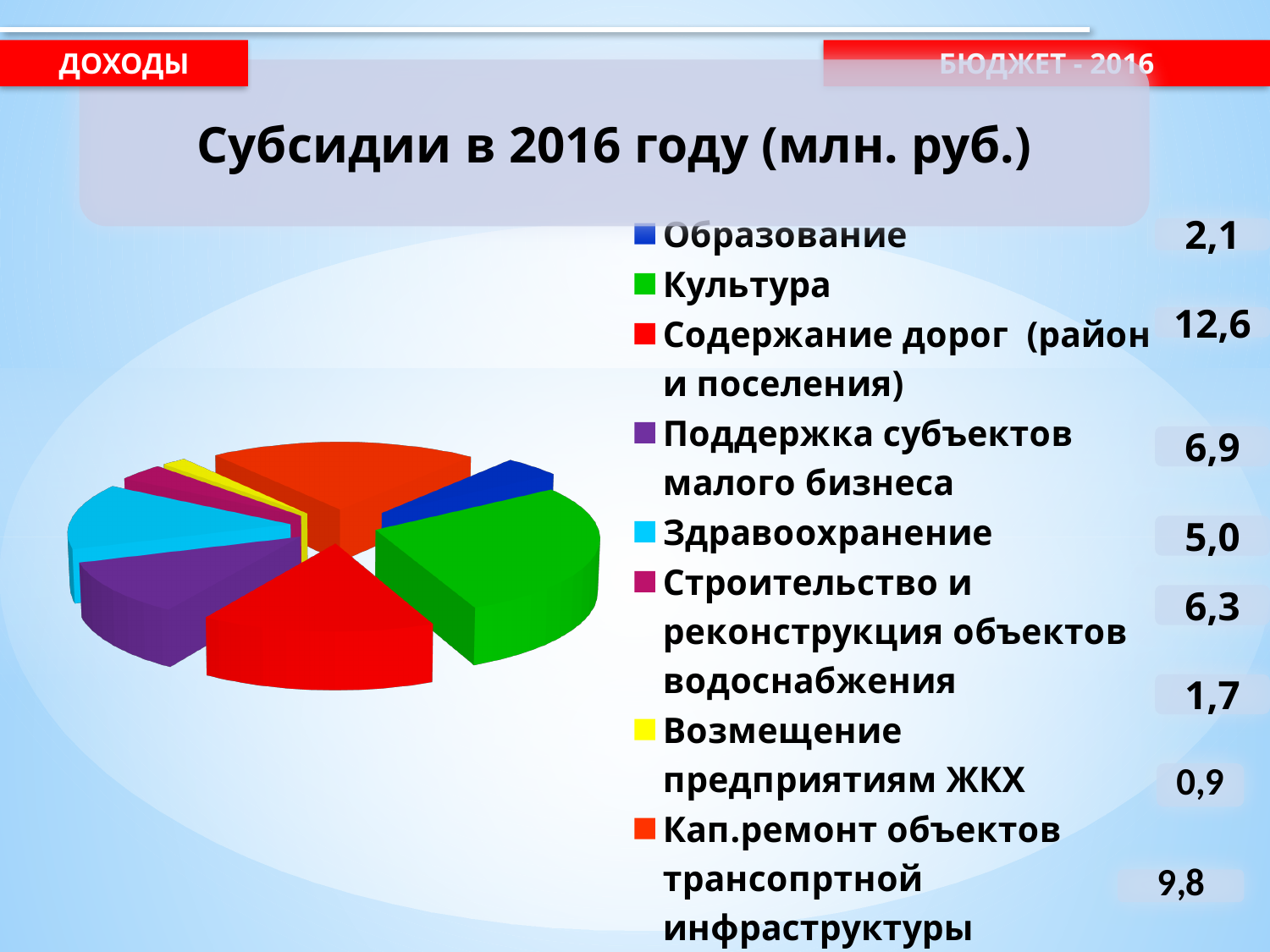
What is the difference between the values for Культура and Образование? 10,5 Which category has the largest slice of the pie? Культура What colour is the slice for Культура? green Which category has the smallest slice of the pie? Возмещение предприятиям ЖКХ What is the title of the chart on the slide? Субсидии в 2016 году (млн. руб.) What is the value for Возмещение предприятиям ЖКХ? 0,9 How many categories does the legend of the pie chart list? 8 What kind of chart is shown on the slide? pie chart What is the value for Кап.ремонт объектов трансопртной инфраструктуры? 9,8 What is the value for Культура? 12,6 Which is larger, the value for Культура or the value for Образование? Культура What is the value for Образование? 2,1